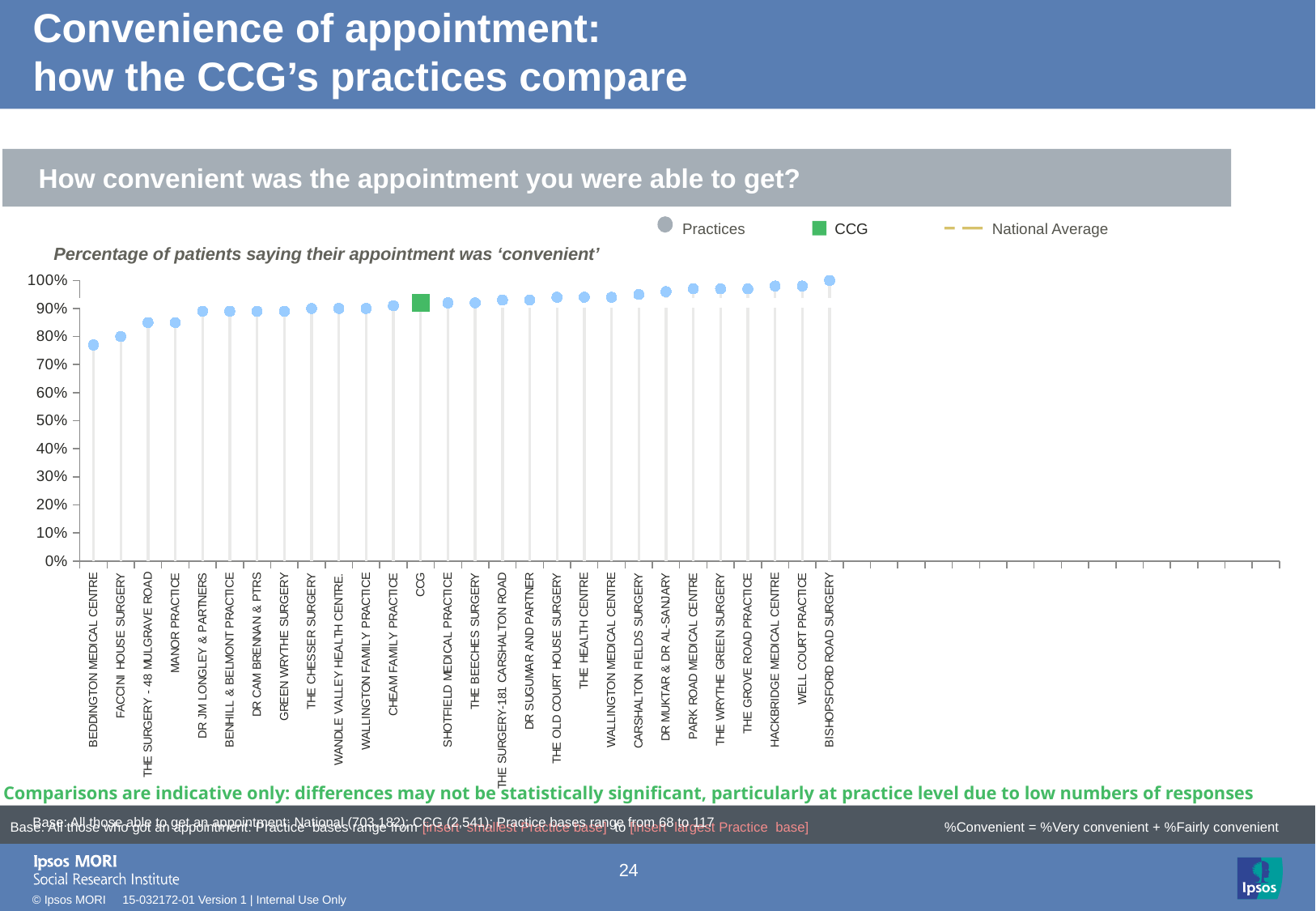
Is the value for Beddington Medical Centre greater or less than 80%? less How many practices (excluding the CCG marker) are plotted on the chart? 27 Which has the higher value, Manor Practice or Hackbridge Medical Centre? Hackbridge Medical Centre Do the values rise or fall moving from left to right along the x axis? rise Is the value for Manor Practice greater or less than 80%? greater Which has the higher value, Beddington Medical Centre or Well Court Practice? Well Court Practice What colour is the marker used for the CCG on the chart? green How many entries does the legend list? 3 Is the value for The Surgery - 48 Mulgrave Road greater or less than 90%? less Which practice has the highest percentage of patients saying their appointment was 'convenient'? Bishopsford Road Surgery Which practice has the lowest percentage of patients saying their appointment was 'convenient'? Beddington Medical Centre